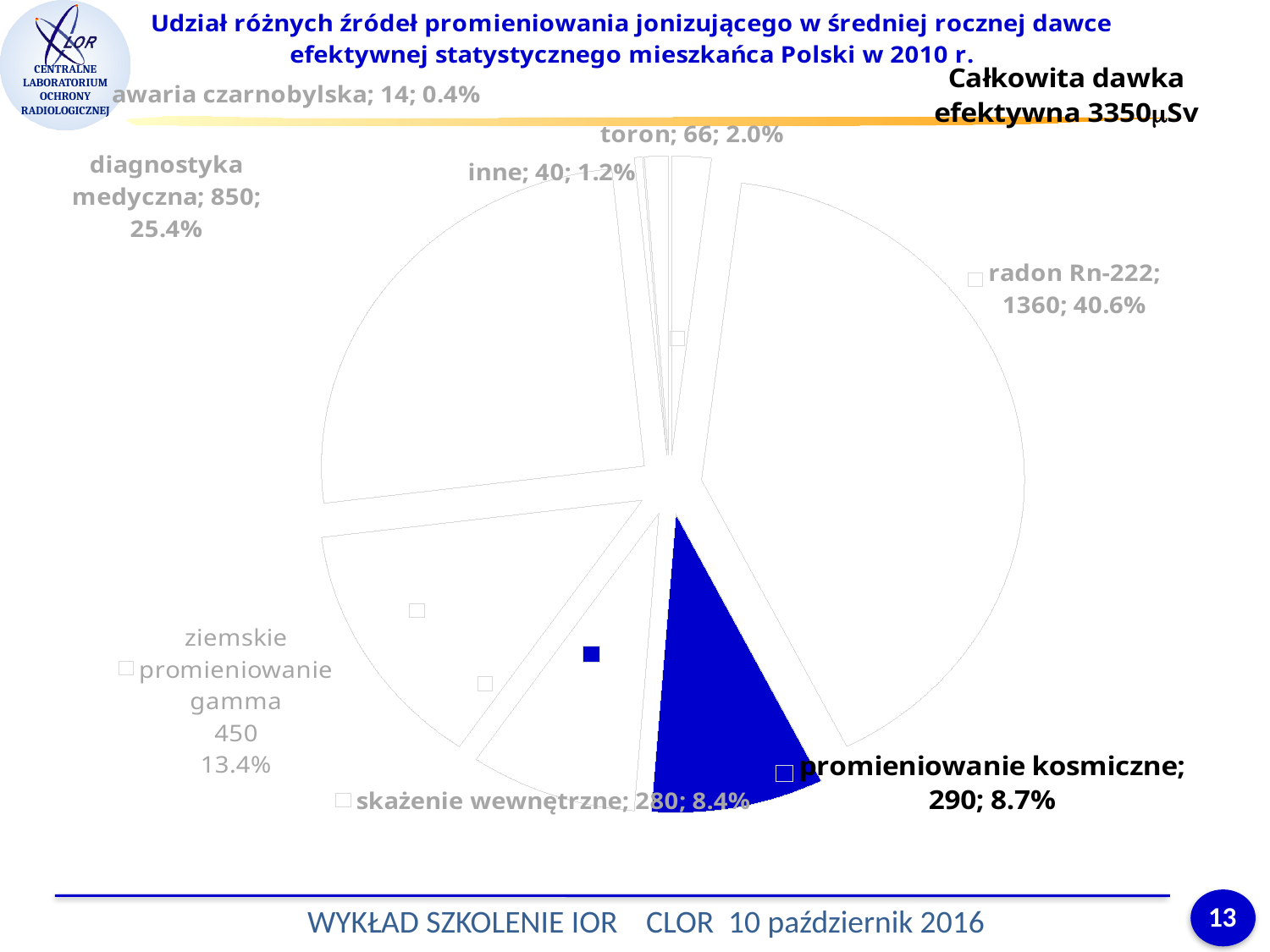
What value is shown for promieniowanie kosmiczne? 290 Which source has the largest share of the pie? radon Rn-222 How many slices does the pie chart have? 8 What total effective dose is stated on the slide? 3350 µSv What is the difference between the values for radon Rn-222 and diagnostyka medyczna? 510 What percentage share is shown for diagnostyka medyczna? 25.4% What value is shown for radon Rn-222? 1360 Which source has the smallest share of the pie? awaria czarnobylska Which is larger, the value for toron or the value for inne? toron Which slice of the pie is filled in blue? promieniowanie kosmiczne What percentage share is shown for ziemskie promieniowanie gamma? 13.4% What kind of chart is shown on the slide? pie chart